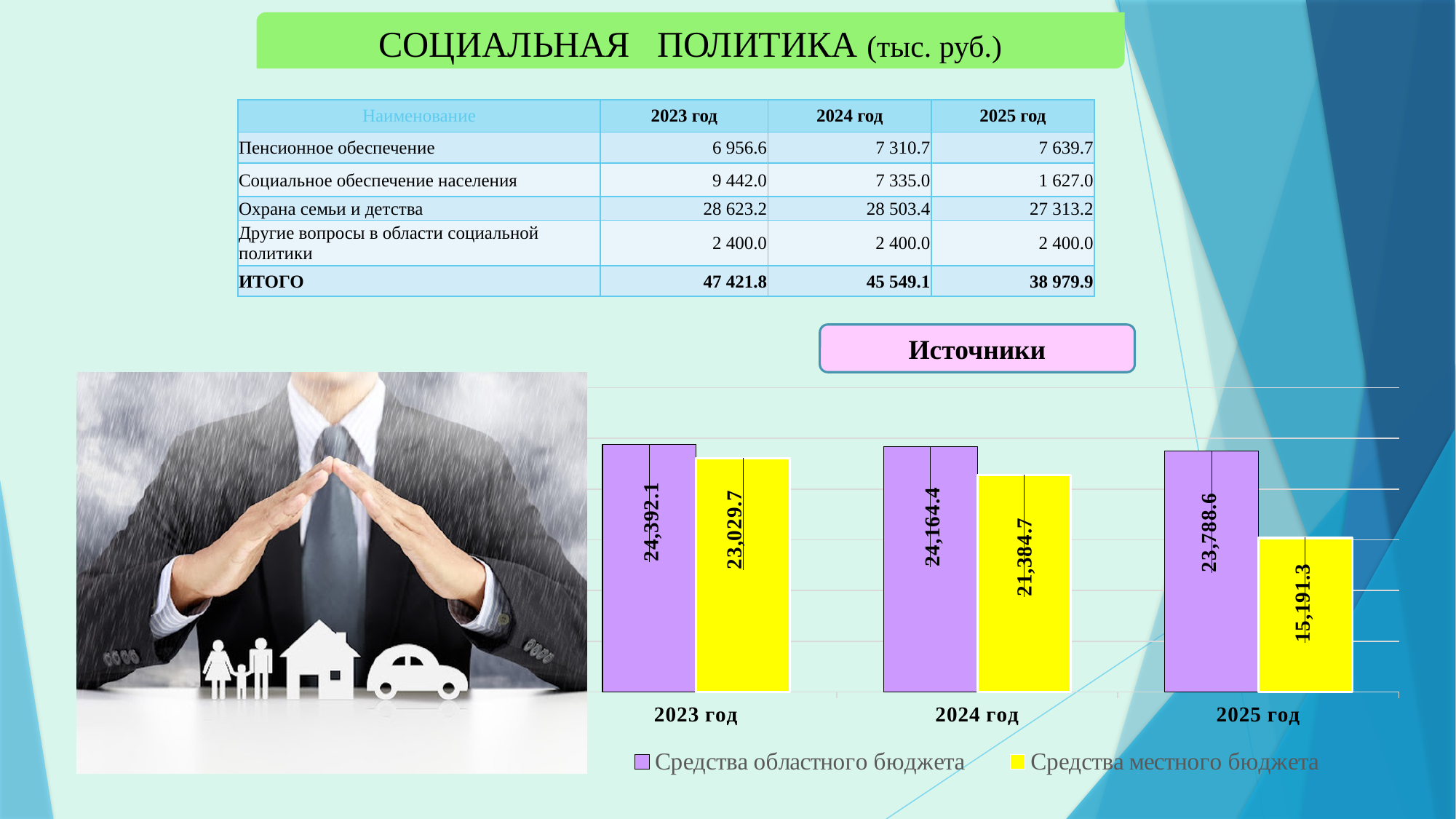
How many year categories are shown on the x axis of the "Источники" chart? 3 How many series does the legend of the "Источники" chart list? 2 In the "Источники" chart, what is the value of Средства местного бюджета for 2025 год? 15,191.3 In the "Источники" chart, what is the difference between Средства областного бюджета and Средства местного бюджета in 2025 год? 8,597.3 In the "Источники" chart, which is larger in 2024 год: Средства областного бюджета or Средства местного бюджета? Средства областного бюджета In the "Источники" chart, what is the difference between Средства областного бюджета and Средства местного бюджета in 2023 год? 1,362.4 What type of chart is shown under the heading "Источники"? bar chart In the "Источники" chart, which year has the lowest value for Средства местного бюджета? 2025 год In the "Источники" chart, what is the value of Средства местного бюджета for 2024 год? 21,384.7 In the "Источники" chart, do the values for Средства местного бюджета rise or fall from 2023 год to 2025 год? fall In the "Источники" chart, which year has the highest value for Средства областного бюджета? 2023 год In the "Источники" chart, what is the value of Средства областного бюджета for 2023 год? 24,392.1